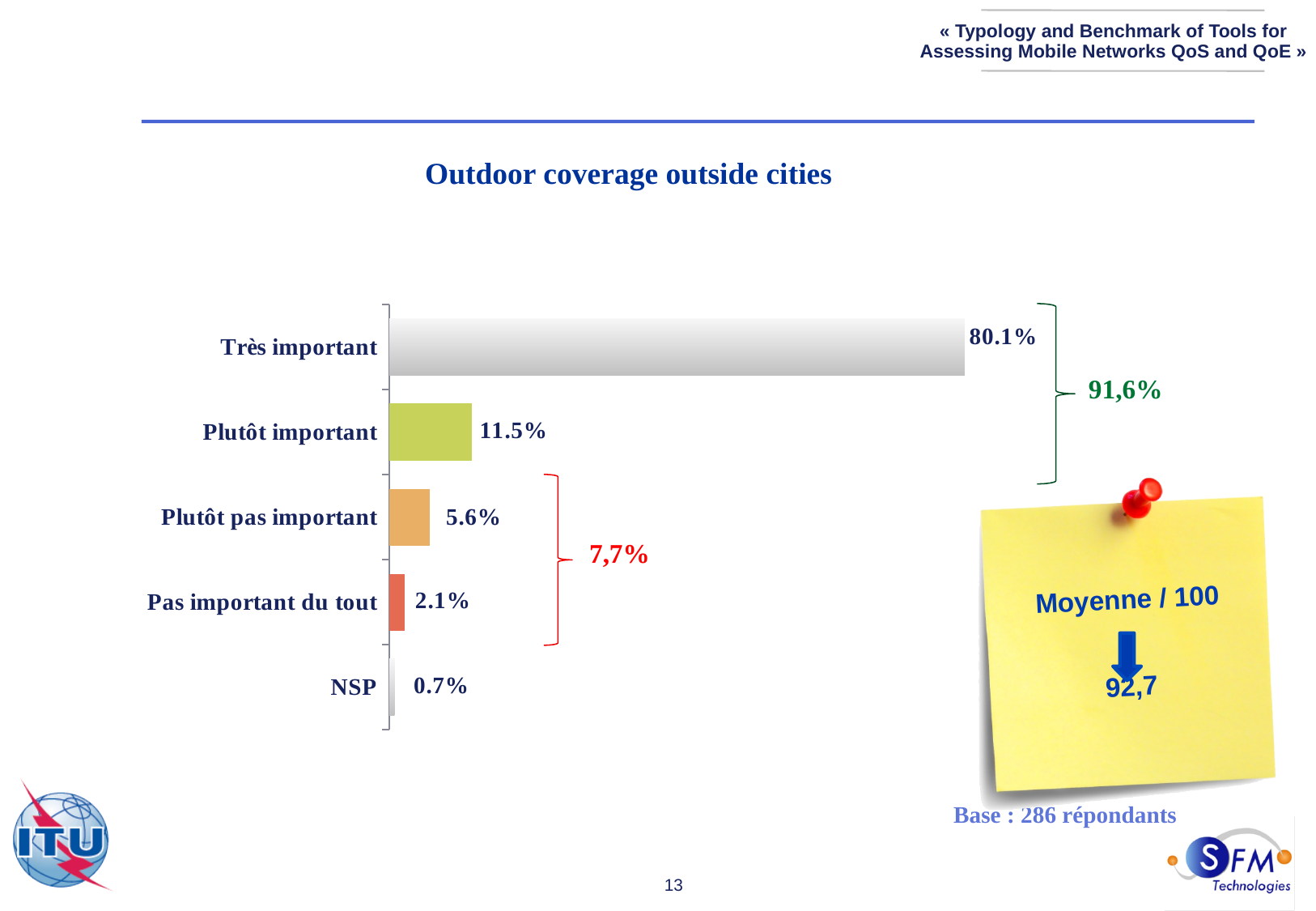
What is the difference between the values for "Très important" and "Plutôt important"? 68.6% How many categories are shown in the chart? 5 What is the value for "Très important"? 80.1% Which category has the lowest value? NSP What is the value for "Plutôt important"? 11.5% Which is larger, the value for "Plutôt pas important" or the value for "Pas important du tout"? Plutôt pas important What is the value for "NSP"? 0.7% What is the title of the chart? Outdoor coverage outside cities What kind of chart is shown on the slide? Bar chart What is the value for "Pas important du tout"? 2.1% What is the value for "Plutôt pas important"? 5.6% Which category has the highest value? Très important